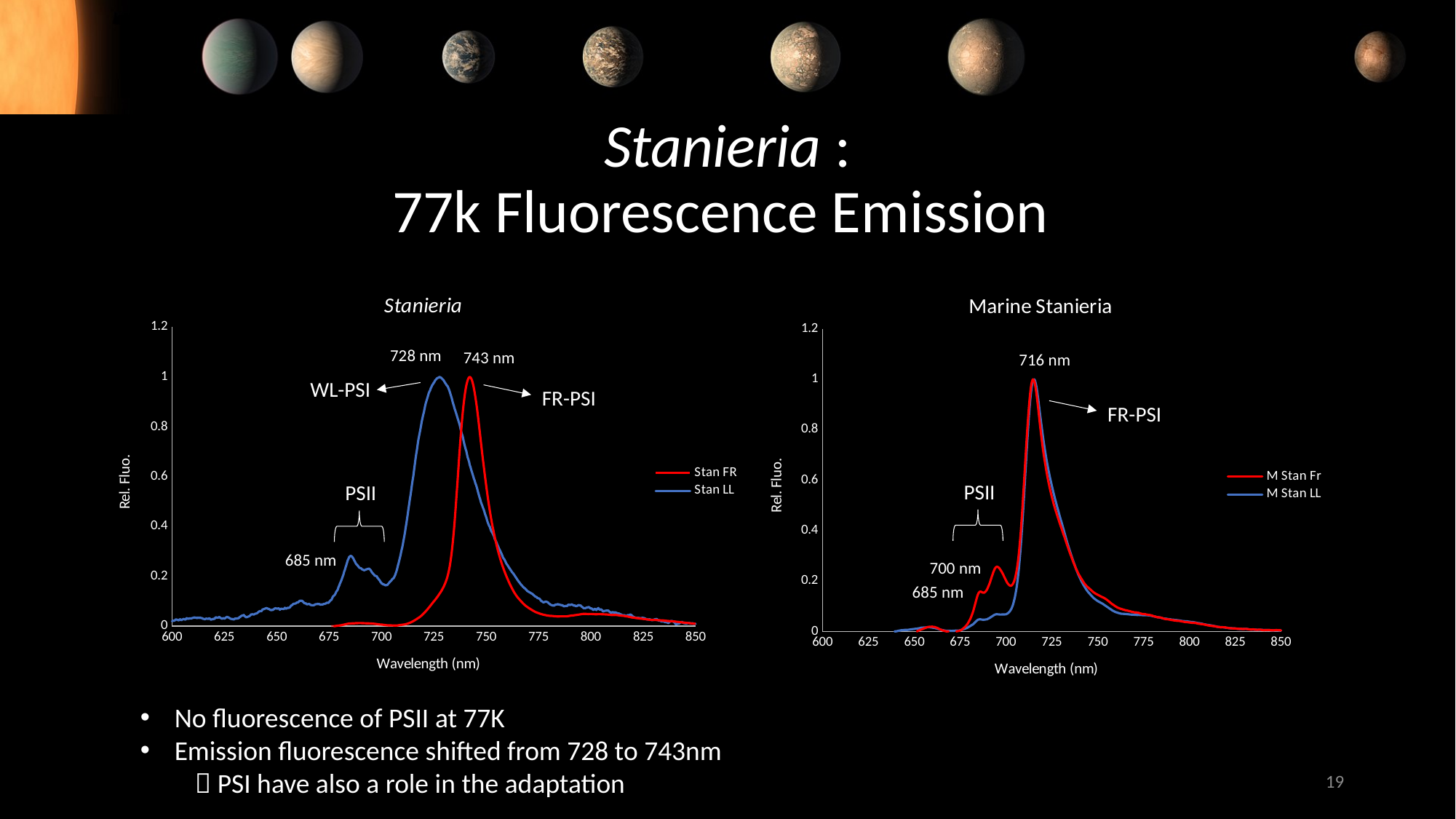
In the Stanieria chart, at what wavelength is the Stan FR peak labelled? 743 nm What are the two series named in the legend of the Marine Stanieria chart? M Stan Fr and M Stan LL How many series does the legend of the Stanieria chart list? 2 What type of chart is the left chart titled Stanieria? line chart What is the label of the x axis on the Marine Stanieria chart? Wavelength (nm) In the Stanieria chart, which series has the larger value at 700 nm, Stan FR or Stan LL? Stan LL In the Stanieria chart, is the value of Stan LL at 685 nm greater or less than 0.4? less In the Stanieria chart, is the value of Stan LL at 685 nm greater or less than 0.2? greater In the Marine Stanieria chart, at what wavelength is the main peak labelled? 716 nm In the Stanieria chart, at what wavelength is the Stan LL peak labelled? 728 nm In the Stanieria chart, which series is drawn in red? Stan FR In the Marine Stanieria chart, is the peak value of M Stan Fr greater or less than 0.8? greater